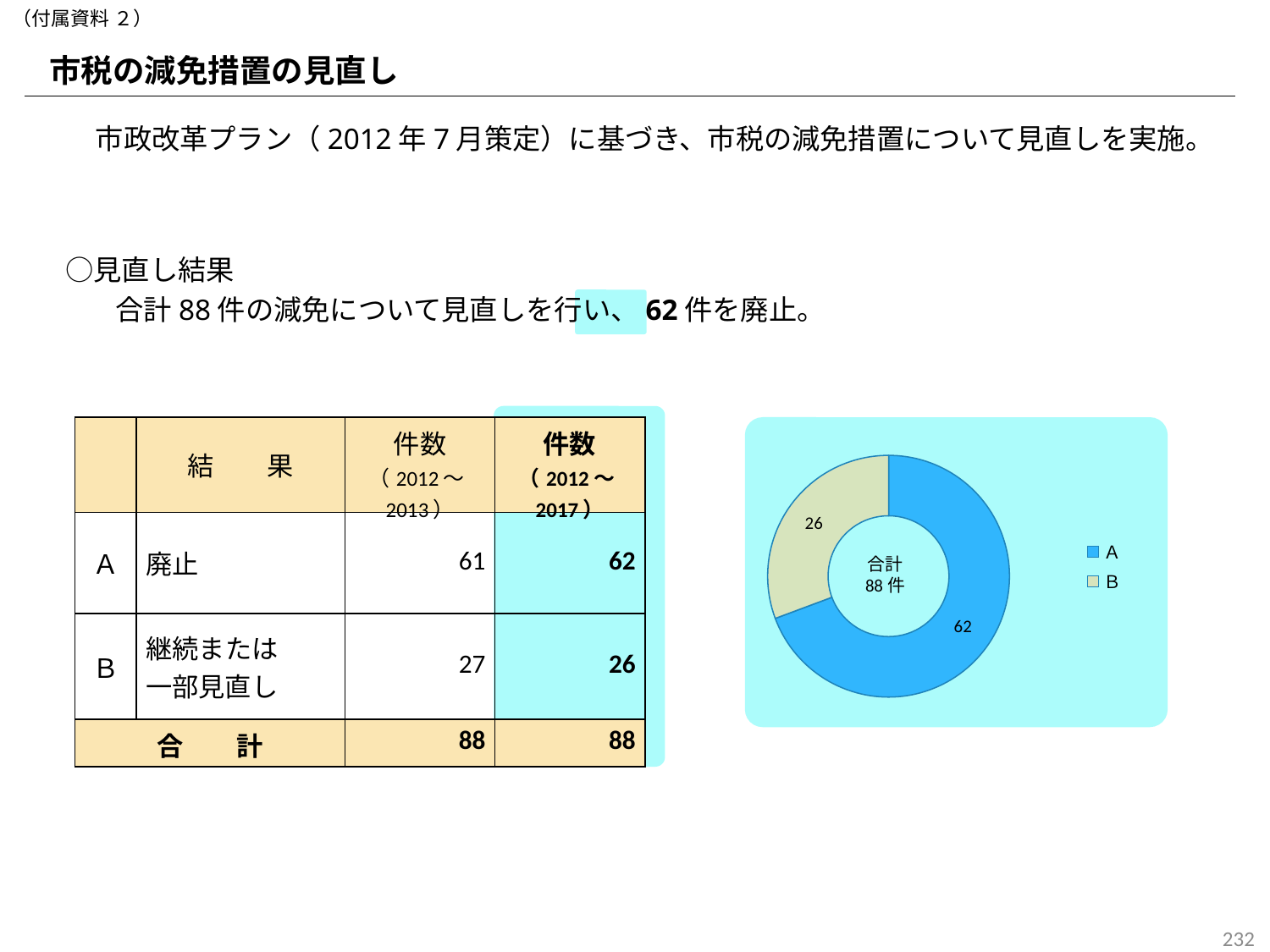
How many entries does the legend of the donut chart list? 2 How many segments does the donut chart have? 2 Which segment of the donut chart is the smallest? B What is the difference between the values for A and B in the donut chart? 36 What kind of chart is shown on the right of the slide? Donut (pie) chart What total is printed in the centre of the donut chart? 合計 88 件 In the donut chart, which is larger, A or B? A What colour is segment A in the donut chart? Blue What are the legend entries of the donut chart? A, B Which segment of the donut chart is the largest? A In the donut chart, what is the value for B? 26 In the donut chart, what is the value for A? 62